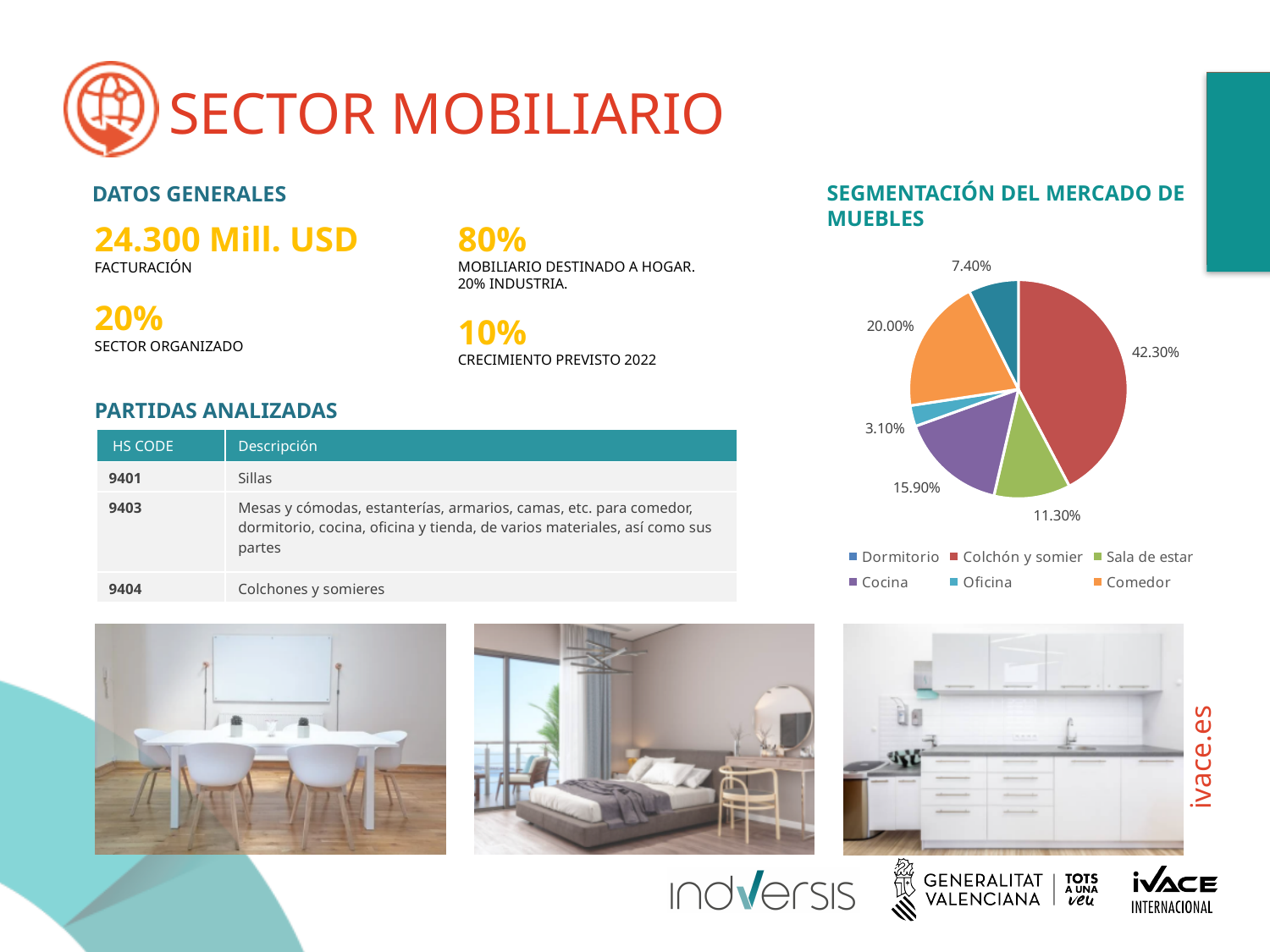
In the pie chart, what is the value for Oficina? 3.10% How many segments does the pie chart have? 6 In the pie chart, what share does Colchón y somier have? 42.30% Which is larger in the pie chart, Sala de estar or Dormitorio? Sala de estar In the pie chart, what is the value for Sala de estar? 11.30% In the pie chart, what is the value for Comedor? 20.00% Which segment has the smallest share in the pie chart? Oficina What is the difference between the shares of Comedor and Cocina in the pie chart? 4.10% What type of chart is used to show the segmentación del mercado de muebles? pie chart In the pie chart, what is the value for Cocina? 15.90% Which segment has the largest share in the pie chart? Colchón y somier In the pie chart, what is the value for Dormitorio? 7.40%